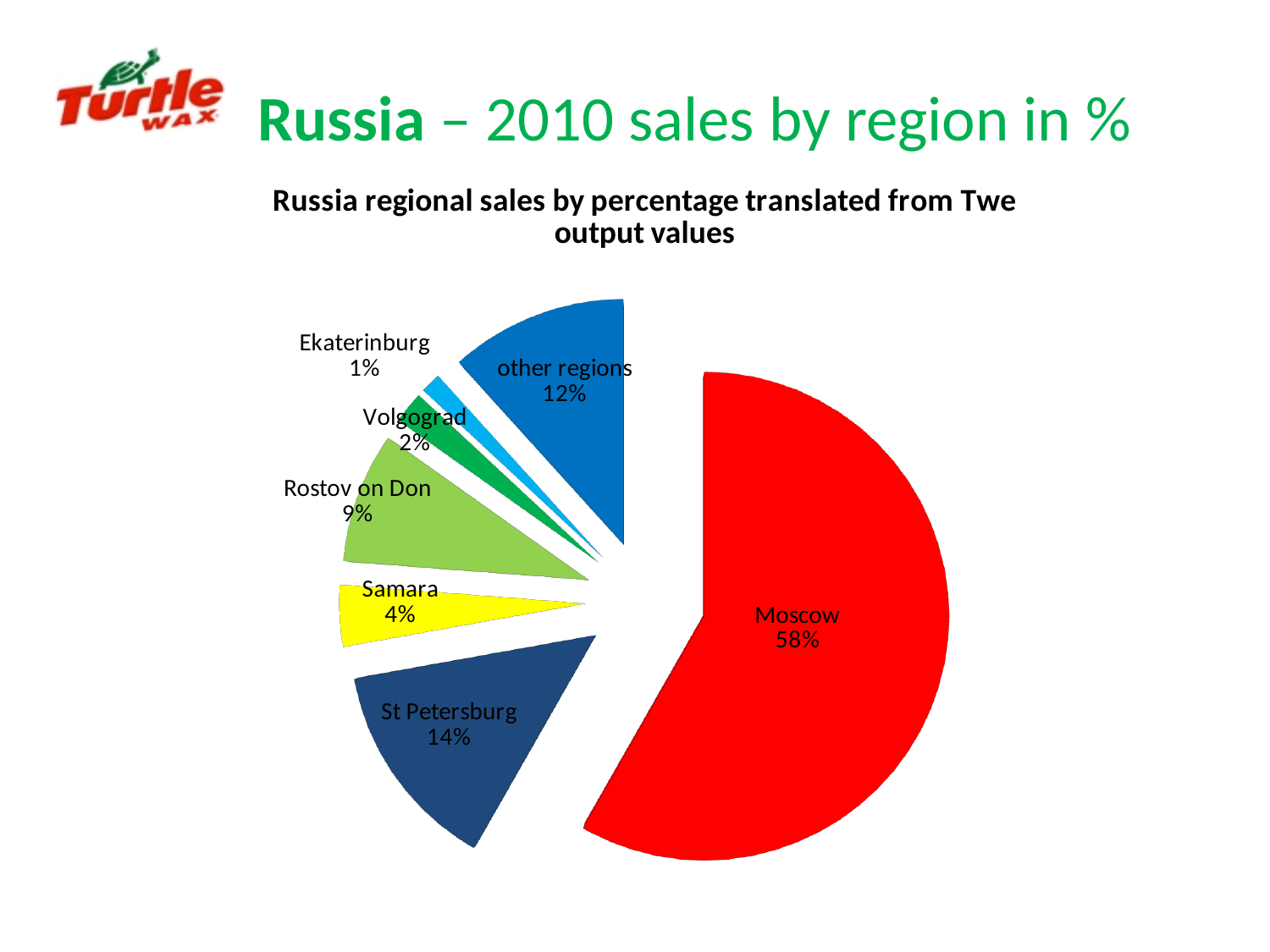
How many slices does the pie chart have? 7 What type of chart is shown on the slide? Pie chart What is the title of the chart? Russia regional sales by percentage translated from Twe output values What share of 2010 Russia sales does Moscow account for? 58% Which has a larger share, Rostov on Don or Samara? Rostov on Don What percentage is shown for Samara? 4% What share of sales comes from other regions? 12% Which region has the largest share of sales? Moscow Which region has the smallest share of sales? Ekaterinburg What is the share for Rostov on Don? 9% What percentage of sales is attributed to St Petersburg? 14% What is the difference in percentage points between Moscow and St Petersburg? 44